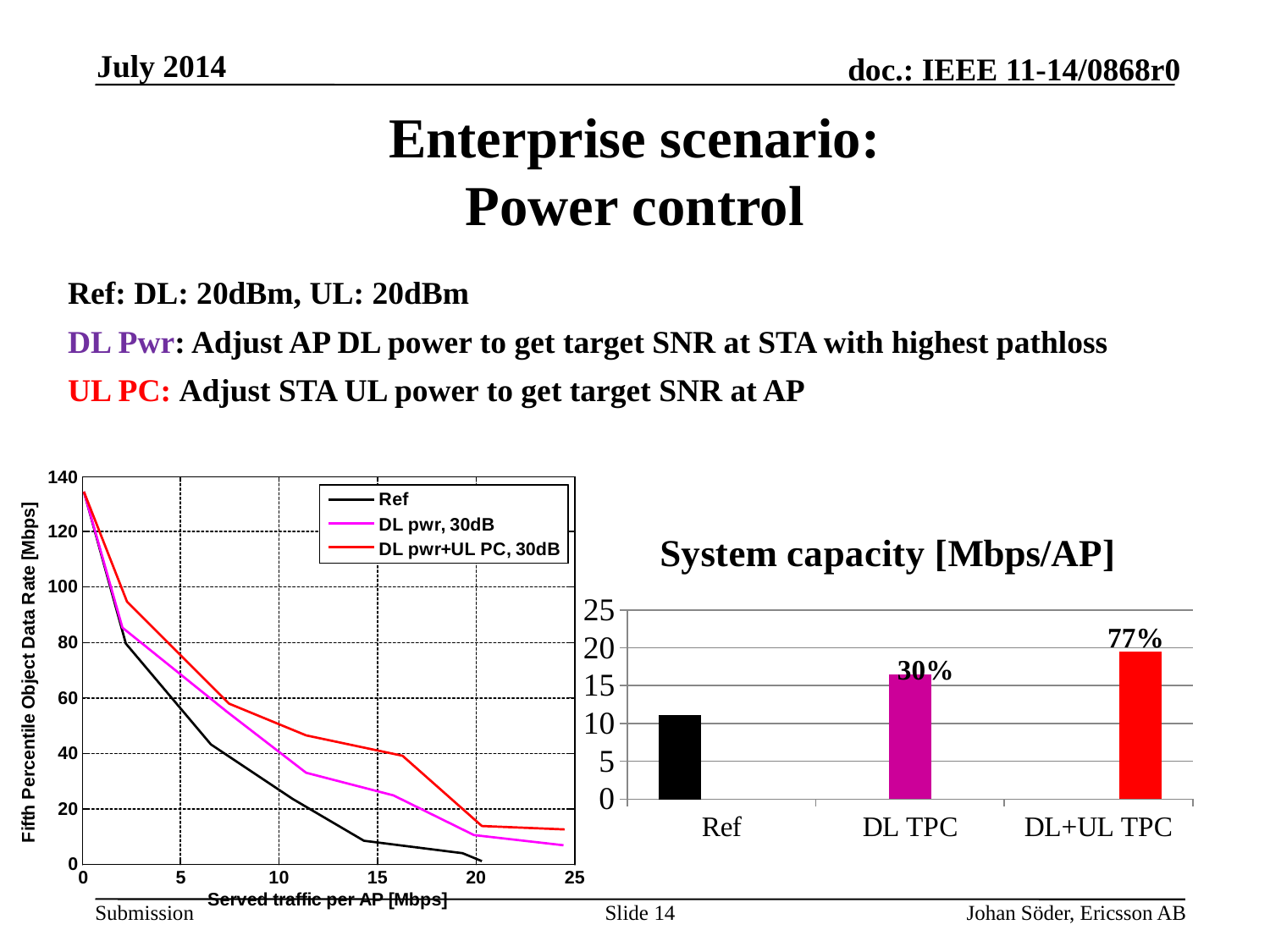
In the 'System capacity [Mbps/AP]' chart, which category has the lowest bar? Ref In the 'System capacity [Mbps/AP]' chart, how many bars are shown? 3 In the 'System capacity [Mbps/AP]' chart, what label is printed above the DL TPC bar? 30% What kind of chart is the 'System capacity [Mbps/AP]' chart? bar chart In the left line chart, what is the label of the x axis? Served traffic per AP [Mbps] In the left line chart, do the values of the Ref series rise or fall as served traffic per AP increases? fall How many series does the legend of the left line chart list? 3 In the 'System capacity [Mbps/AP]' chart, is the value for Ref greater or less than 15? less In the 'System capacity [Mbps/AP]' chart, what label is printed above the DL+UL TPC bar? 77% In the 'System capacity [Mbps/AP]' chart, which category has the highest bar? DL+UL TPC In the 'System capacity [Mbps/AP]' chart, is the value for DL+UL TPC greater or less than 15? greater What kind of chart is the chart on the left of the slide? line chart